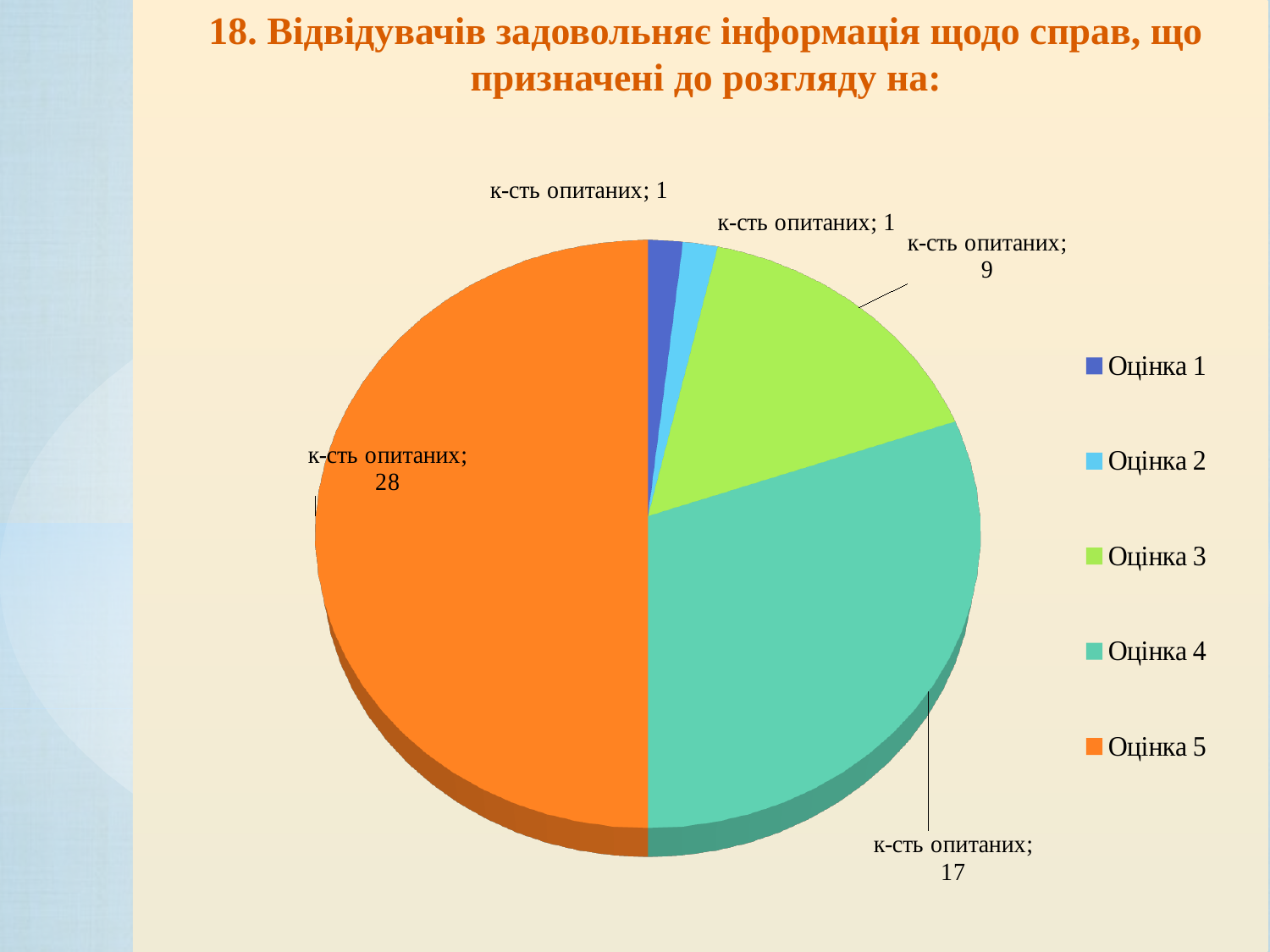
What kind of chart is shown on the slide? pie chart Which category has the largest slice? Оцінка 5 How many entries does the legend list? 5 Which is larger, the value for Оцінка 3 or the value for Оцінка 4? Оцінка 4 What is the value for Оцінка 3? 9 What is the value for Оцінка 1? 1 How many slices does the pie chart have? 5 What is the value for Оцінка 4? 17 What share of the pie does Оцінка 5 represent? 50% What is the difference between the values for Оцінка 5 and Оцінка 4? 11 What colour is the slice for Оцінка 4? teal (green-blue) What is the value for Оцінка 5? 28